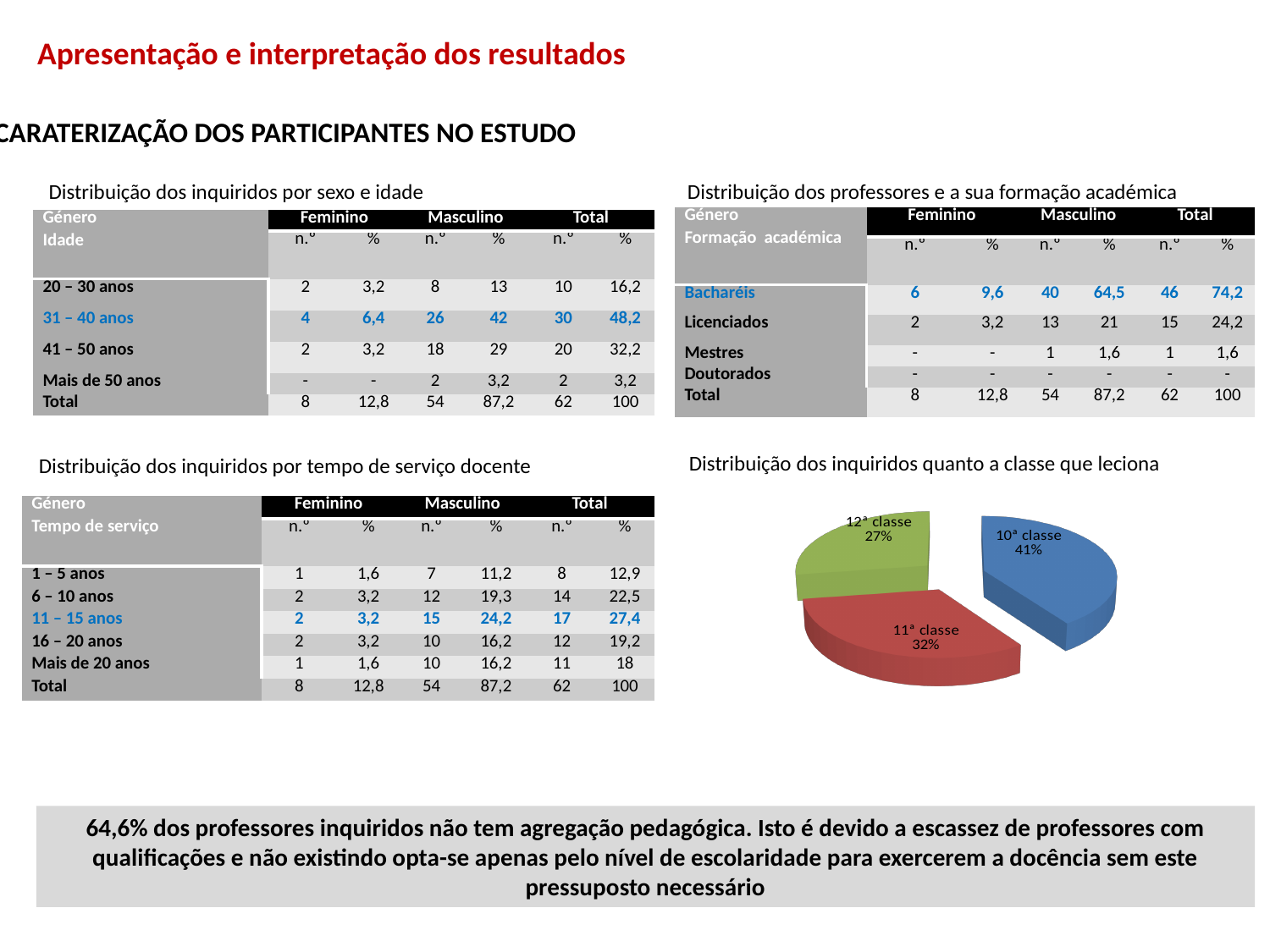
In the pie chart, what colour is the 11ª classe slice? red In the pie chart, what share of respondents teach 12ª classe? 27% In the pie chart, which is larger: the share for 11ª classe or the share for 12ª classe? 11ª classe In the pie chart, what is the difference in percentage points between the 10ª classe and 12ª classe shares? 14 In the pie chart, which class has the smallest share? 12ª classe In the pie chart, what share of respondents teach 10ª classe? 41% What is the title of the pie chart on the slide? Distribuição dos inquiridos quanto a classe que leciona What kind of chart is shown under the title 'Distribuição dos inquiridos quanto a classe que leciona'? pie chart In the pie chart, how many slices are there? 3 In the pie chart, what share of respondents teach 11ª classe? 32% In the pie chart, which class has the largest share? 10ª classe In the pie chart, what is the difference in percentage points between the 11ª classe and 12ª classe shares? 5